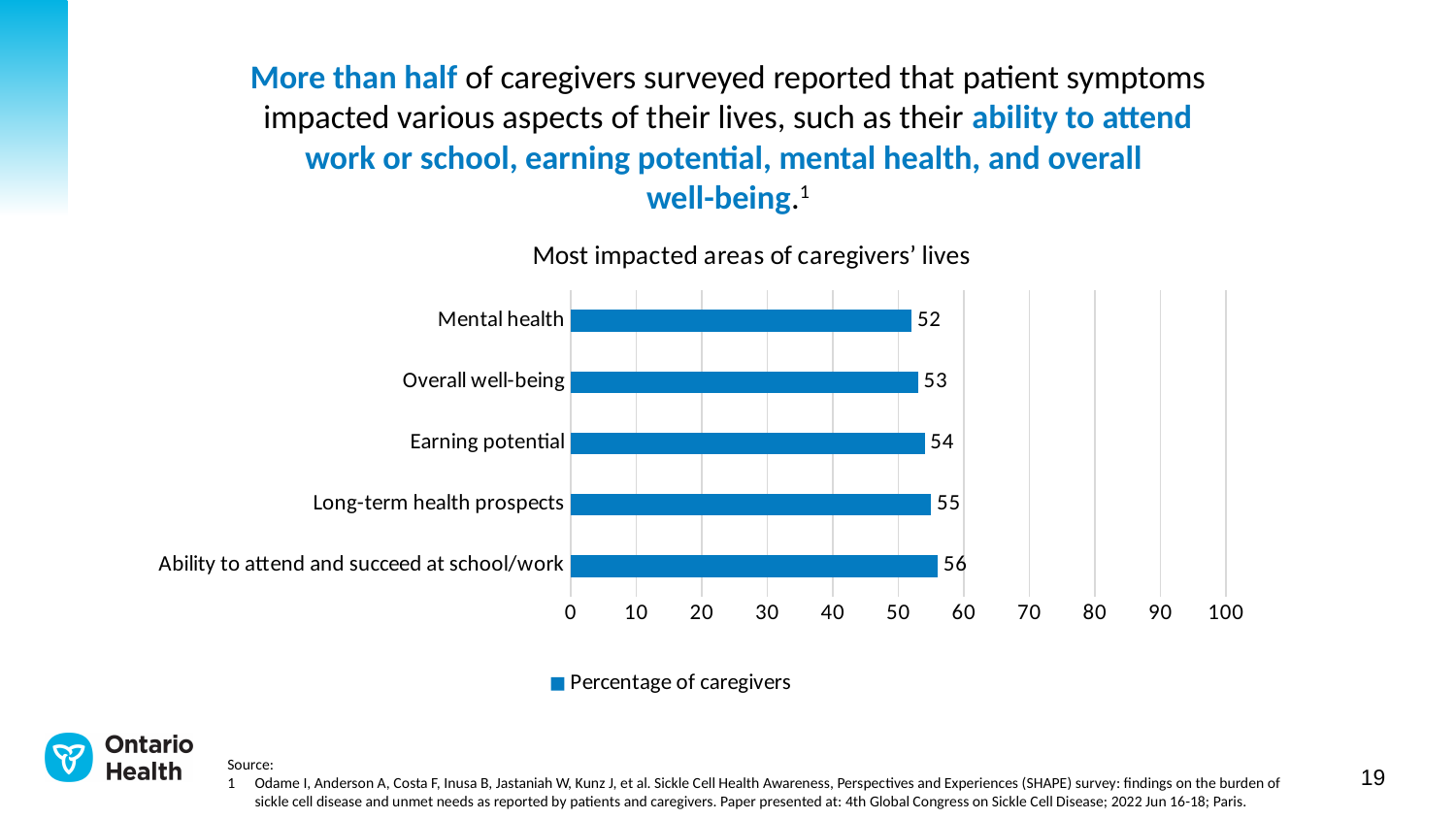
What is the value for Earning potential? 54 Is the value for Overall well-being greater or less than 60? less How many categories are shown in the chart? 5 How many series does the legend list? 1 What is the title of the chart? Most impacted areas of caregivers' lives What kind of chart is shown? bar chart What is the value for Mental health? 52 What is the difference between the values for Ability to attend and succeed at school/work and Mental health? 4 Which category has the lowest value? Mental health What is the value for Ability to attend and succeed at school/work? 56 Which is larger, the value for Long-term health prospects or the value for Overall well-being? Long-term health prospects Which category has the highest value? Ability to attend and succeed at school/work